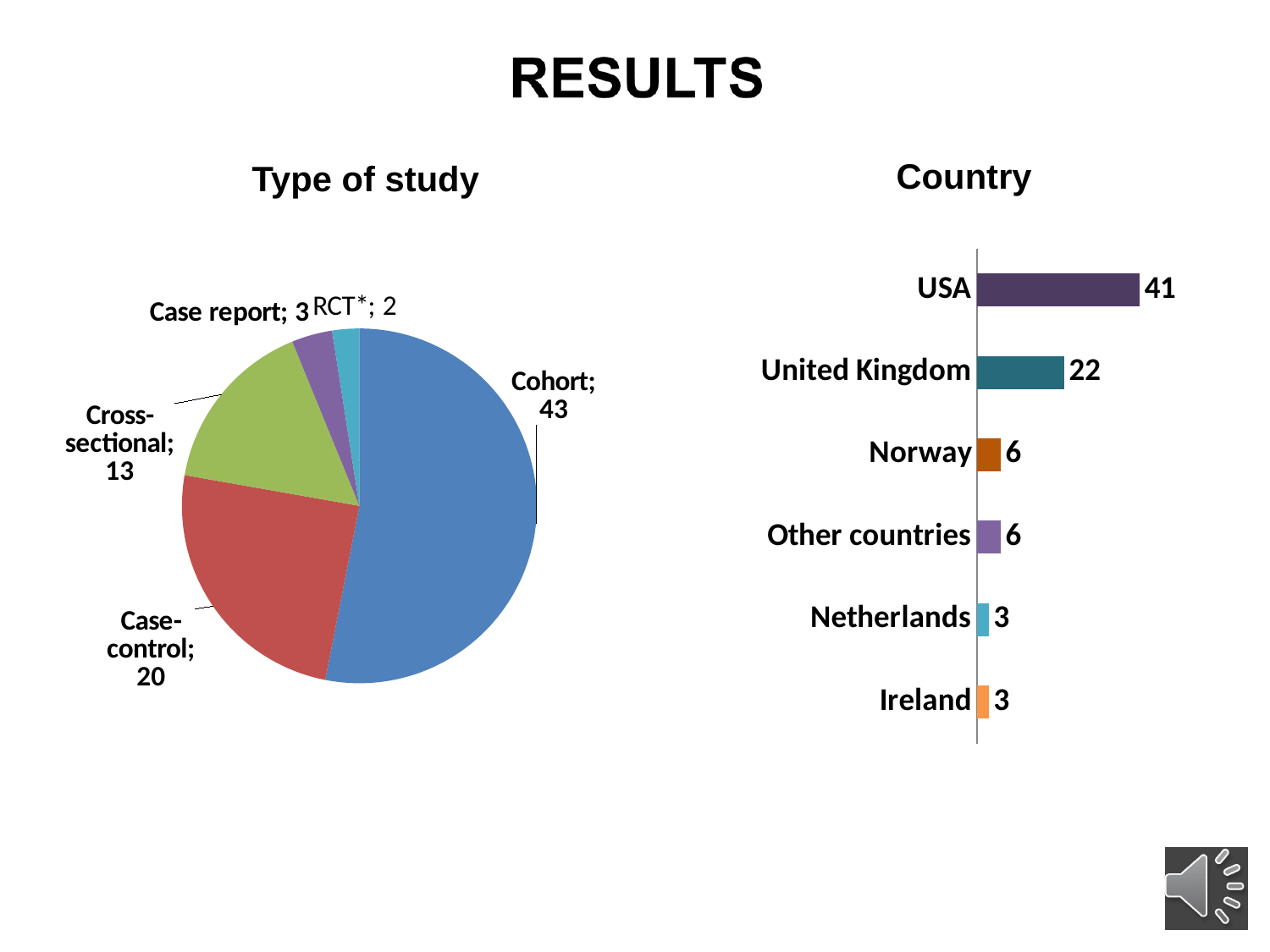
In the 'Country' chart, how many countries/categories are shown? 6 What kind of chart is the 'Type of study' chart? Pie chart In the 'Type of study' chart, what is the difference between Cohort and Case-control? 23 In the 'Country' chart, which is larger, Norway or Netherlands? Norway In the 'Country' chart, what is the value for United Kingdom? 22 In the 'Type of study' chart, what is the value for Cohort? 43 In the 'Type of study' chart, what is the value for Cross-sectional? 13 In the 'Country' chart, what is the difference between USA and United Kingdom? 19 In the 'Type of study' chart, how many slices does the pie have? 5 In the 'Type of study' chart, which type of study has the smallest slice? RCT* What kind of chart is the 'Country' chart? Bar chart In the 'Country' chart, which country has the highest value? USA